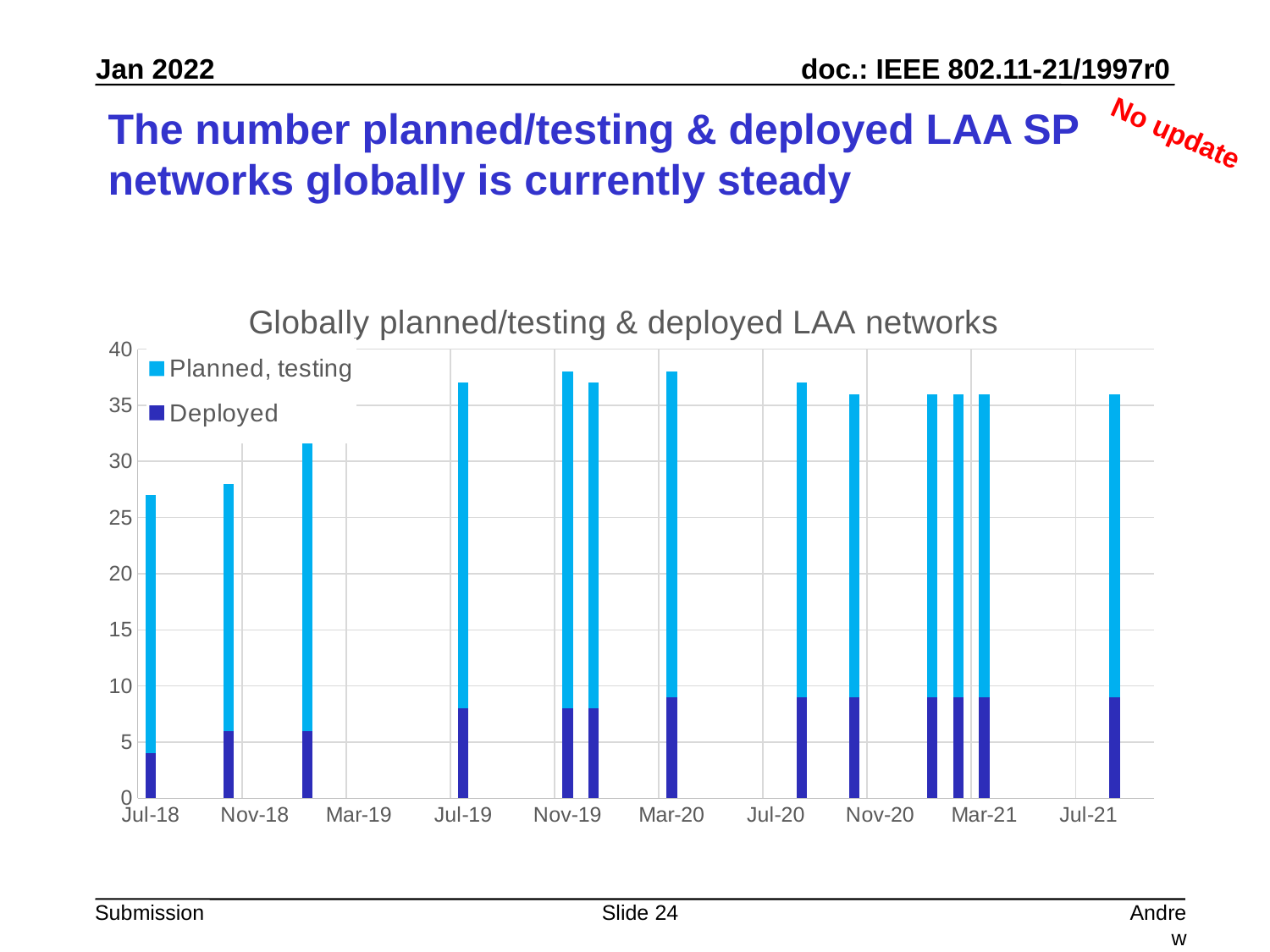
Is the Deployed value of the bar at Jul-18 greater or less than 5? less Is the Deployed value of the bar at Mar-20 greater or less than 10? less Which bar has the larger total value, the one at Jul-18 or the one at Jul-19? Jul-19 How do the total values change from Jul-18 to Jul-19 along the x axis? They rise Which bar has the lowest total value in the chart? Jul-18 What kind of chart is shown on the slide? Stacked bar chart How many series does the chart legend list? 2 What is the title of the chart? Globally planned/testing & deployed LAA networks Is the Deployed value of the bar at Mar-20 greater or less than 5? greater Which series is shown in dark blue in the chart? Deployed